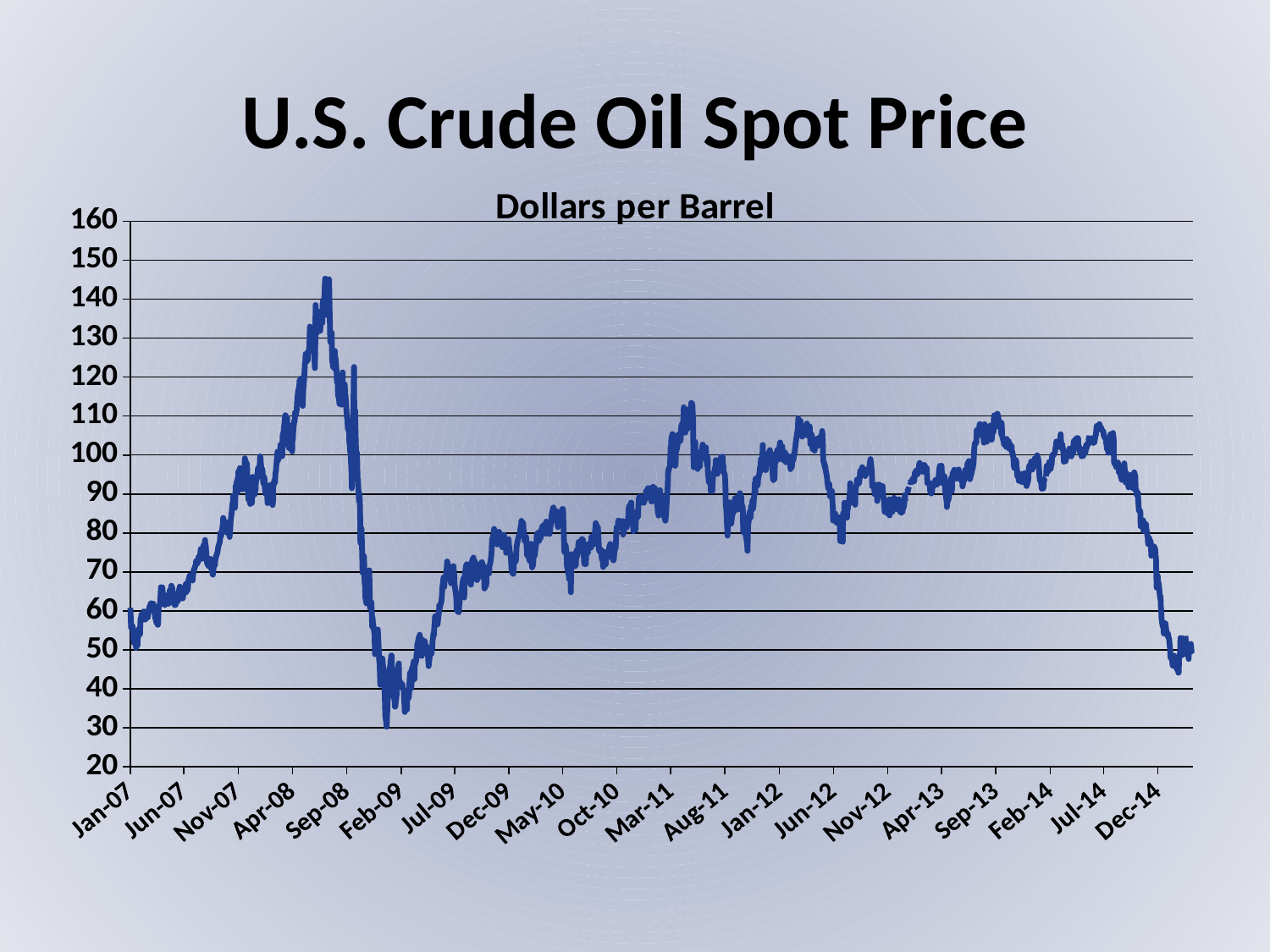
How many date labels are shown on the x axis? 20 Near which x-axis label does the line reach its highest value? Sep-08 Is the value at the end of the series (after Dec-14) greater or less than 60? less Does the line rise or fall between Jul-14 and the end of the series? fall What is the title of the chart? Dollars per Barrel What unit is the crude oil price plotted in, according to the chart subtitle? Dollars per Barrel Does the line rise or fall between Jan-07 and Sep-08? rise Is the lowest value of the line around Feb-09 greater or less than 40? less Is the peak value of the line around Sep-08 greater or less than 140? greater Near which x-axis label does the line reach its lowest value? Feb-09 What kind of chart is shown on the slide? line chart